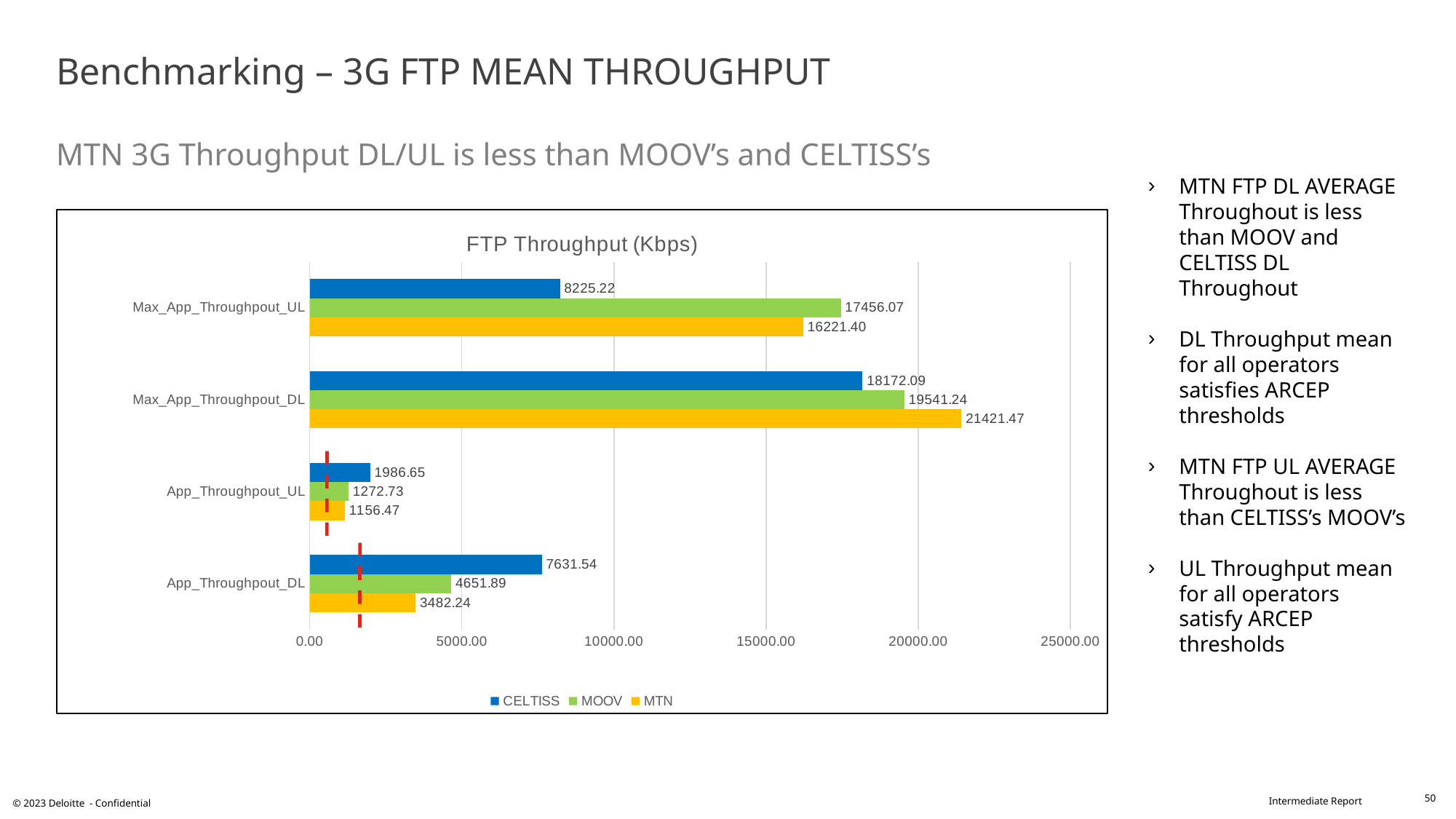
What is the MTN value for Max_App_Throughpout_DL? 21421.47 What is the title of the chart? FTP Throughput (Kbps) What is the CELTISS value for App_Throughpout_UL? 1986.65 Which operator has the highest value for App_Throughpout_DL? CELTISS What type of chart is shown on the slide? Bar chart What is the MOOV value for Max_App_Throughpout_UL? 17456.07 Which is larger for Max_App_Throughpout_DL, the MOOV value or the CELTISS value? MOOV How many categories are shown on the chart? 4 Which operator has the lowest value for Max_App_Throughpout_UL? CELTISS Is the MTN value for Max_App_Throughpout_UL greater or less than 15000.00? greater How many series does the legend list? 3 What is the difference between the CELTISS and MTN values for App_Throughpout_DL? 4149.30